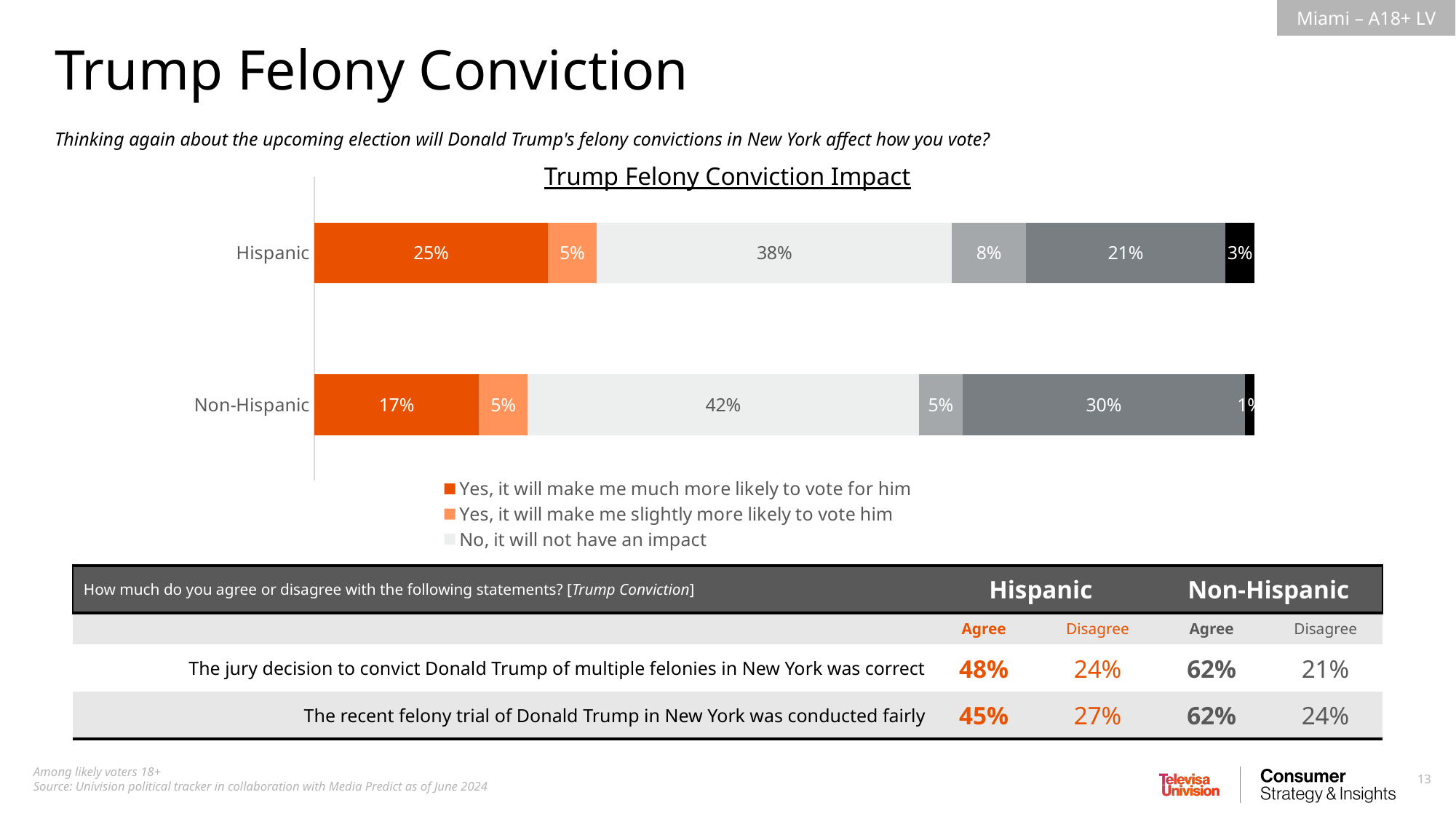
How many entries does the chart's legend list? 3 What is the chart's title? Trump Felony Conviction Impact What is the value of the black segment at the end of the Hispanic bar? 3% What type of chart is shown under the title 'Trump Felony Conviction Impact'? Stacked bar chart Which group has the larger share saying the conviction will not have an impact, Hispanic or Non-Hispanic? Non-Hispanic What percentage of Non-Hispanic respondents said the conviction will not have an impact? 42% How many categories (bars) does the chart show? 2 What percentage of Hispanic respondents said the conviction will make them much more likely to vote for Trump? 25% What is the difference in percentage points between Hispanic and Non-Hispanic respondents who said the conviction will make them much more likely to vote for Trump? 8 percentage points Which segment is the largest in the Hispanic bar? No, it will not have an impact (38%) What is the value of the dark gray segment in the Non-Hispanic bar? 30% What percentage of Non-Hispanic respondents said the conviction will make them much more likely to vote for Trump? 17%